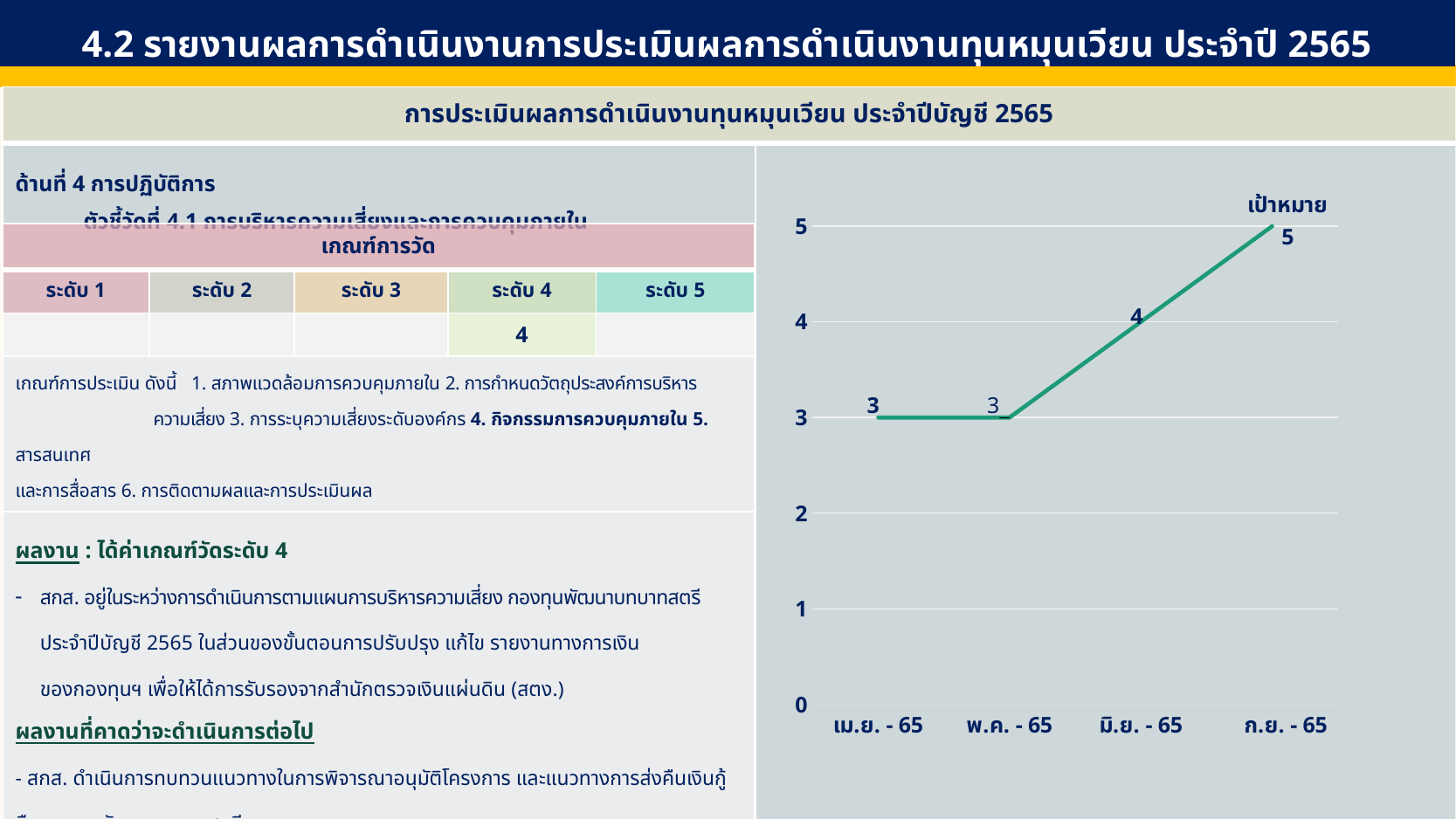
What is the highest value shown on the y axis of the line chart? 5 Which is larger on the line chart, the value for มิ.ย. - 65 or the value for พ.ค. - 65? มิ.ย. - 65 Which category has the highest value on the line chart? ก.ย. - 65 What is the value for ก.ย. - 65 on the line chart? 5 What is the difference between the values for ก.ย. - 65 and เม.ย. - 65 on the line chart? 2 How many data points are plotted on the line chart? 4 What is the value for พ.ค. - 65 on the line chart? 3 What is the value for เม.ย. - 65 on the line chart? 3 What kind of chart is shown on the right side of the slide? line chart What label is written above the last point of the line chart? เป้าหมาย Do the values on the line chart rise or fall from เม.ย. - 65 to ก.ย. - 65? rise What is the value for มิ.ย. - 65 on the line chart? 4